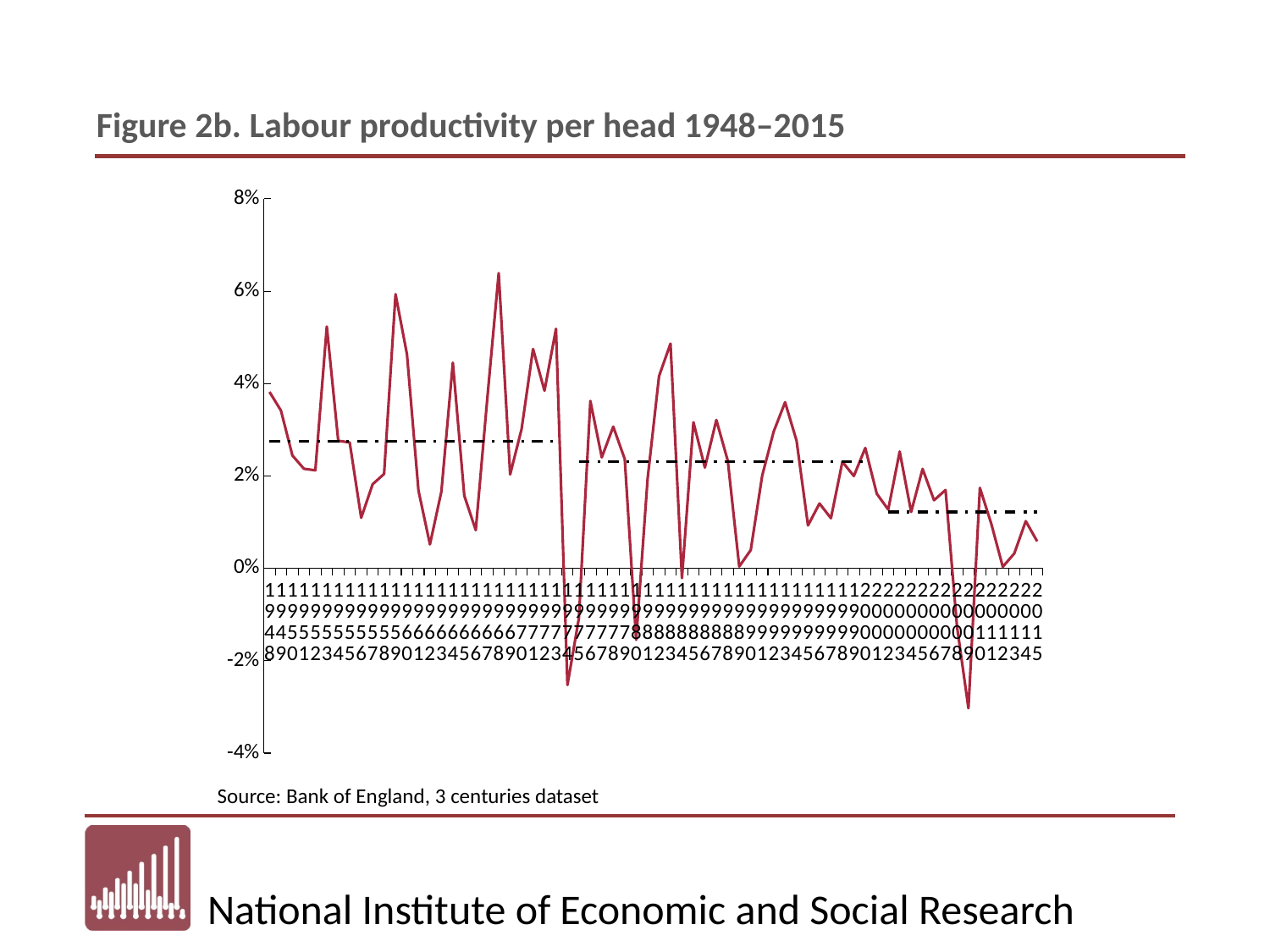
What source is cited below the chart? Bank of England, 3 centuries dataset Overall, do the values rise or fall from 1948 to 2015? fall Is the value for 2015 greater or less than 2%? less Is the value for 2009 greater or less than -2%? less Which year has the highest labour productivity growth value on the chart? 1968 What is the title of the chart? Figure 2b. Labour productivity per head 1948–2015 Which year has the lowest labour productivity growth value on the chart? 2009 What kind of chart is shown on the slide? Line chart Is the value for 1948 greater or less than 2%? greater How many years are plotted on the x axis? 68 Which year has the larger value, 1948 or 2015? 1948